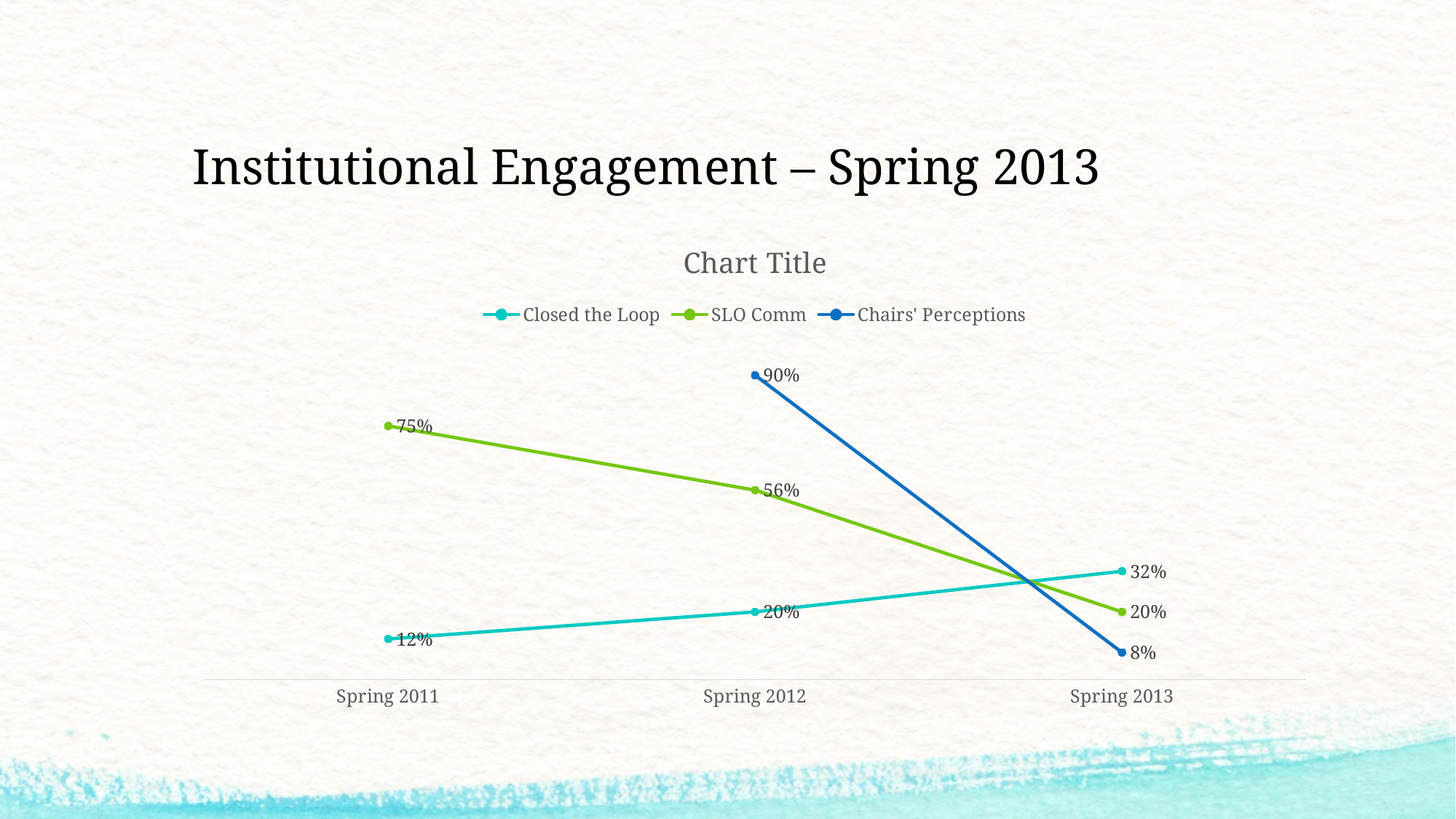
What is the value for SLO Comm in Spring 2011? 75% Does the Closed the Loop series rise or fall from Spring 2011 to Spring 2013? Rise In which period is the SLO Comm value lowest? Spring 2013 What kind of chart is shown? Line chart What is the value for Closed the Loop in Spring 2013? 32% What is the difference between the SLO Comm values in Spring 2011 and Spring 2013? 55% In which period is the Closed the Loop value highest? Spring 2013 Which is larger in Spring 2012: SLO Comm or Closed the Loop? SLO Comm What is the value for Chairs' Perceptions in Spring 2012? 90% How many series does the legend list? 3 How many periods are shown on the x axis? 3 What is the value for Chairs' Perceptions in Spring 2013? 8%